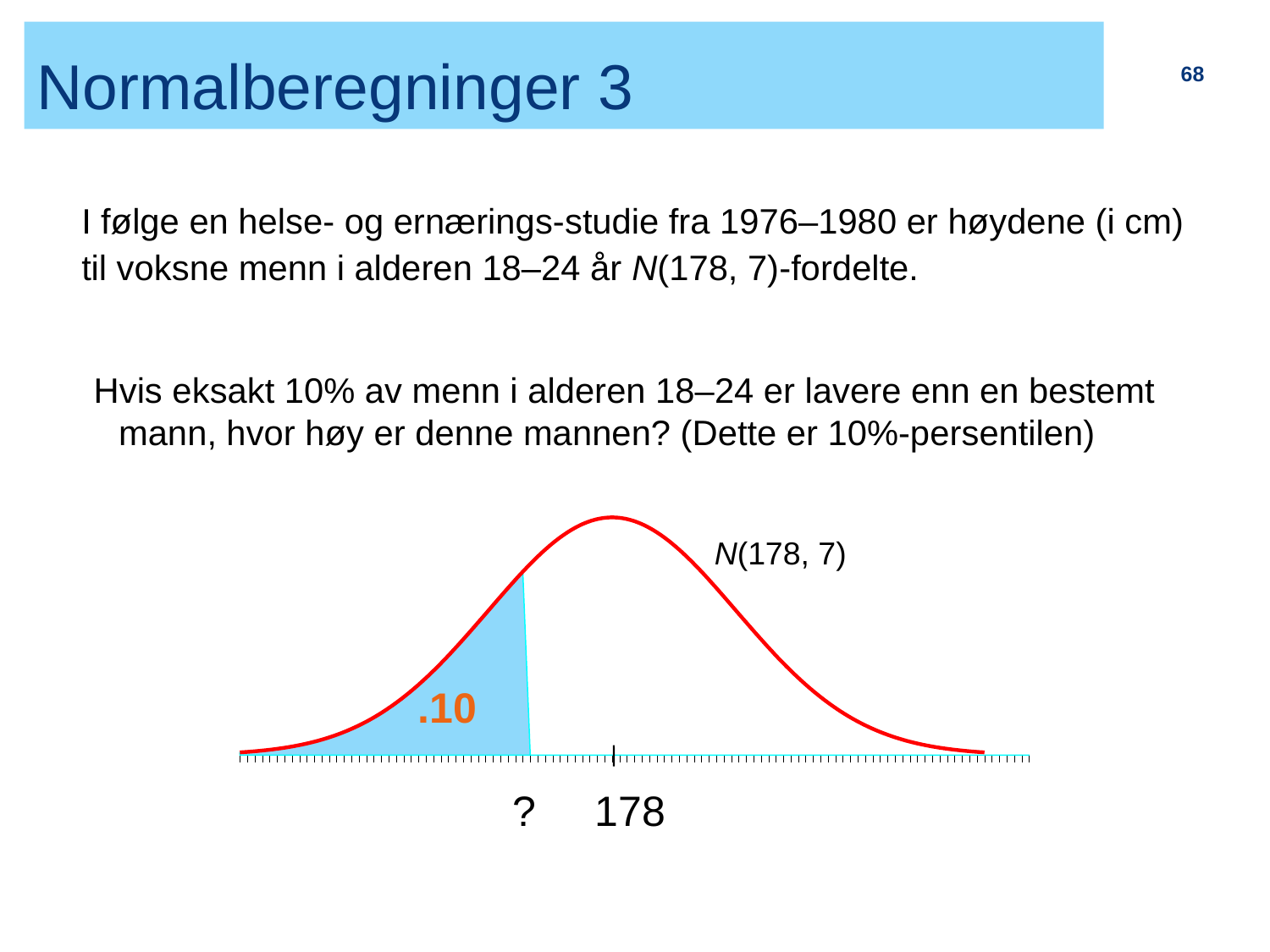
What value is marked at the centre of the horizontal axis under the peak of the curve? 178 Is the shaded region located to the left or to the right of 178? Left What distribution label is written next to the curve? N(178, 7) What colour is the normal curve drawn in? Red Does the curve rise or fall as it moves from the left end of the axis toward 178? Rises What symbol marks the unknown cutoff value on the horizontal axis? ? What colour is the shaded area under the curve? Light blue Is the unknown value marked with '?' on the axis greater or less than 178? Less What proportion is printed inside the shaded region of the curve? .10 What kind of chart is shown on the slide? A normal distribution (bell) curve